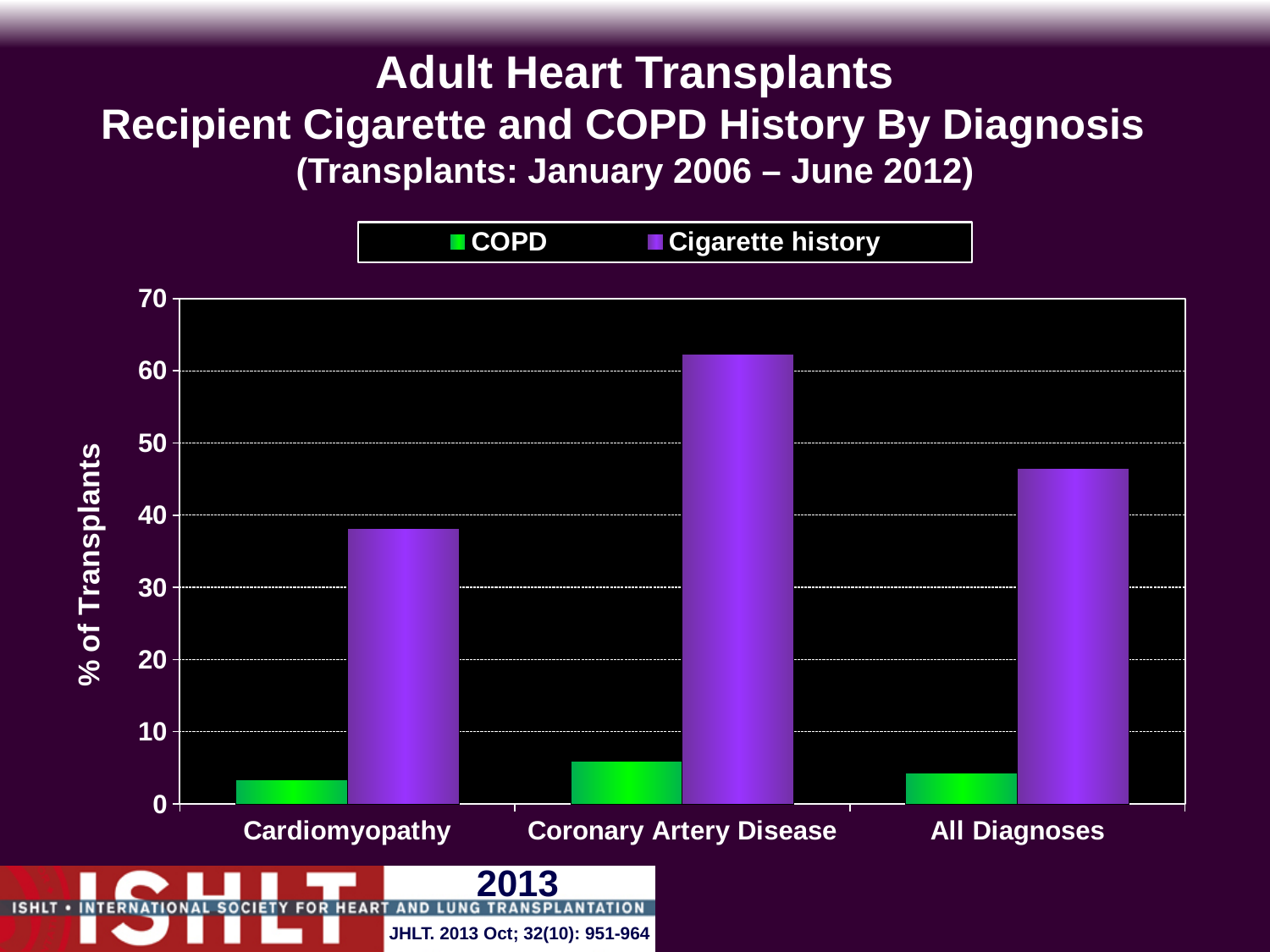
Which is larger: the Cigarette history value for All Diagnoses or for Cardiomyopathy? All Diagnoses Which diagnosis category has the lowest Cigarette history value? Cardiomyopathy Is the Cigarette history value for Cardiomyopathy greater or less than 40? less What kind of chart is shown on the slide? bar chart What is the label of the y axis? % of Transplants How many series does the legend list? 2 Which diagnosis category has the highest COPD value? Coronary Artery Disease Is the Cigarette history value for Coronary Artery Disease greater or less than 60? greater How many diagnosis categories are shown on the x axis? 3 Which colour represents the Cigarette history series in the legend? purple Which diagnosis category has the highest Cigarette history value? Coronary Artery Disease Is the COPD value for All Diagnoses greater or less than 10? less